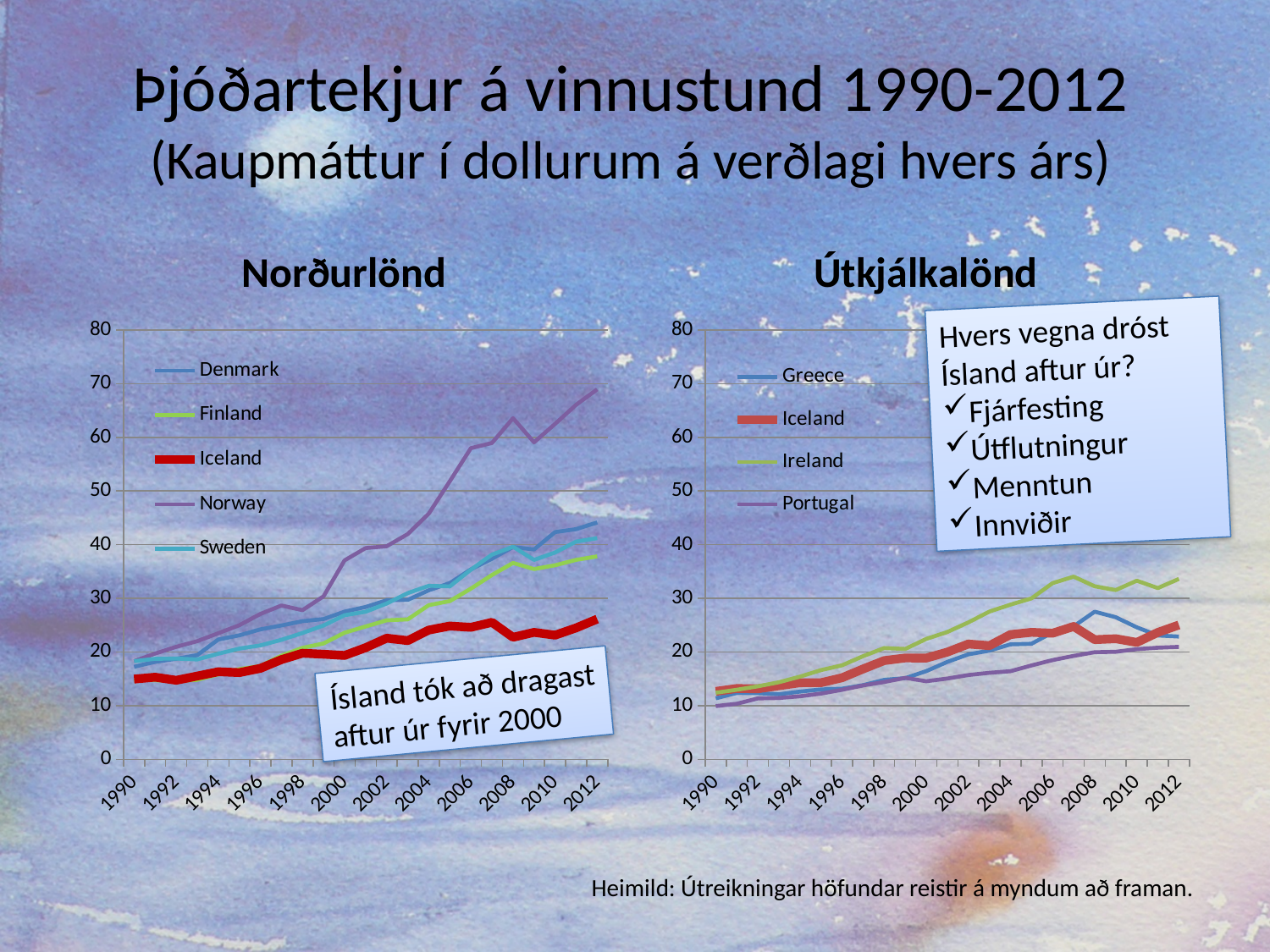
In the Útkjálkalönd chart, is the value for Ireland in 2012 greater or less than 30? greater In the Norðurlönd chart, which country has the highest value in 2012? Norway In the Útkjálkalönd chart, which country has the highest value in 2012? Ireland In the Útkjálkalönd chart, which is larger in 2012, the value for Ireland or the value for Portugal? Ireland How many series does the legend of the Útkjálkalönd chart list? 4 How many series does the legend of the Norðurlönd chart list? 5 In the Norðurlönd chart, is the value for Iceland in 2012 greater or less than 30? less What kind of chart is the Norðurlönd chart on the left? line chart In the Norðurlönd chart, is the value for Norway in 2012 greater or less than 60? greater In the Norðurlönd chart, which country has the lowest value in 2012? Iceland Which countries are listed in the legend of the Útkjálkalönd chart? Greece, Iceland, Ireland, Portugal In the Norðurlönd chart, does the Norway line generally rise or fall from 1990 to 2012? rise